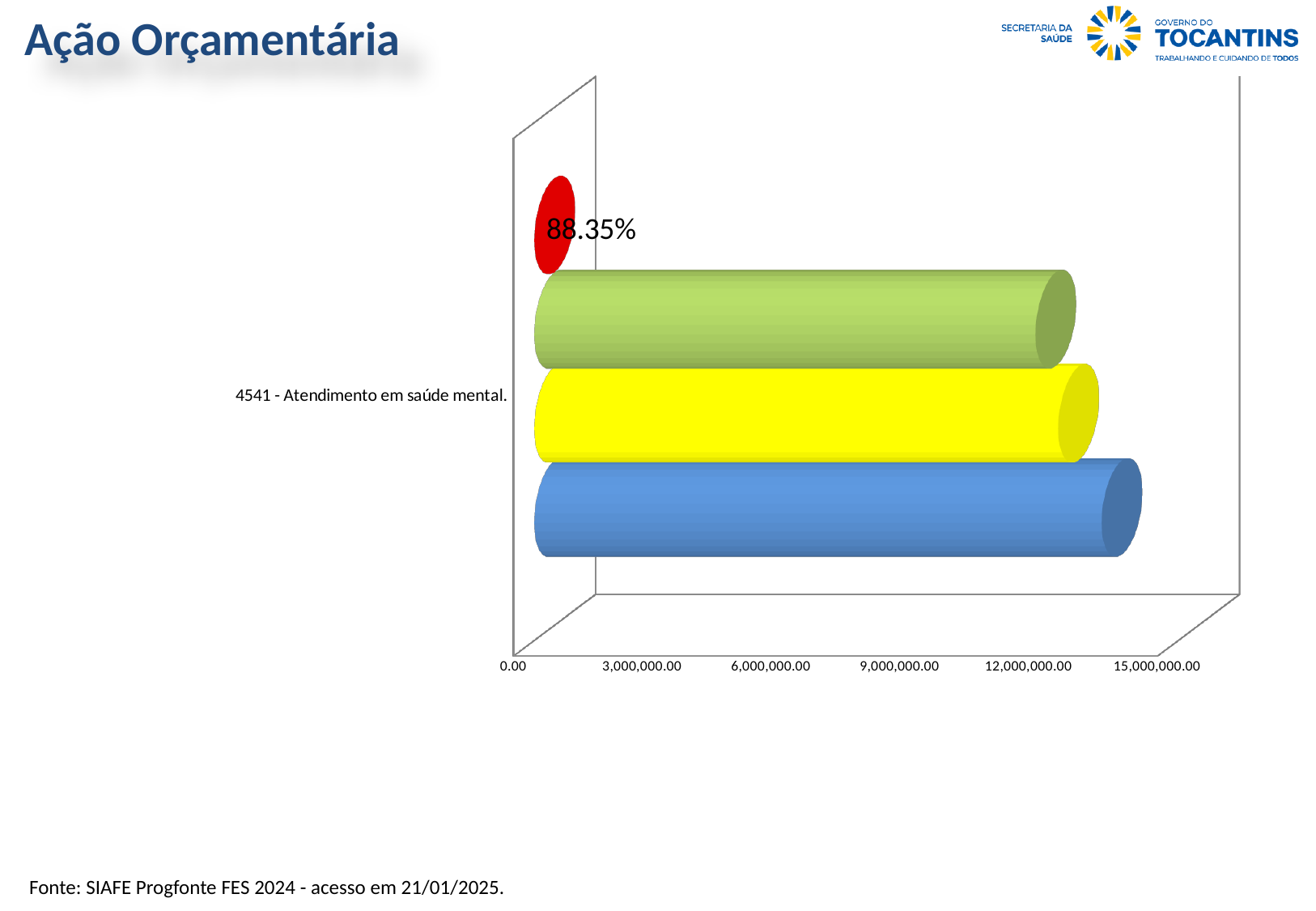
Which is larger, the blue bar or the green bar? blue What kind of chart is shown on the slide? bar chart Is the value of the yellow bar greater or less than 9,000,000.00? greater How many bars are plotted for the category '4541 - Atendimento em saúde mental.'? 3 Which coloured bar is the shortest in the chart? green Is the value of the green bar greater or less than 15,000,000.00? less How many categories are shown on the vertical axis of the chart? 1 Is the value of the blue bar greater or less than 12,000,000.00? greater Which coloured bar is the longest in the chart? blue What percentage value is printed on the chart next to the red marker? 88.35% What is the highest value shown on the horizontal axis of the chart? 15,000,000.00 What is the category label shown on the vertical axis of the chart? 4541 - Atendimento em saúde mental.